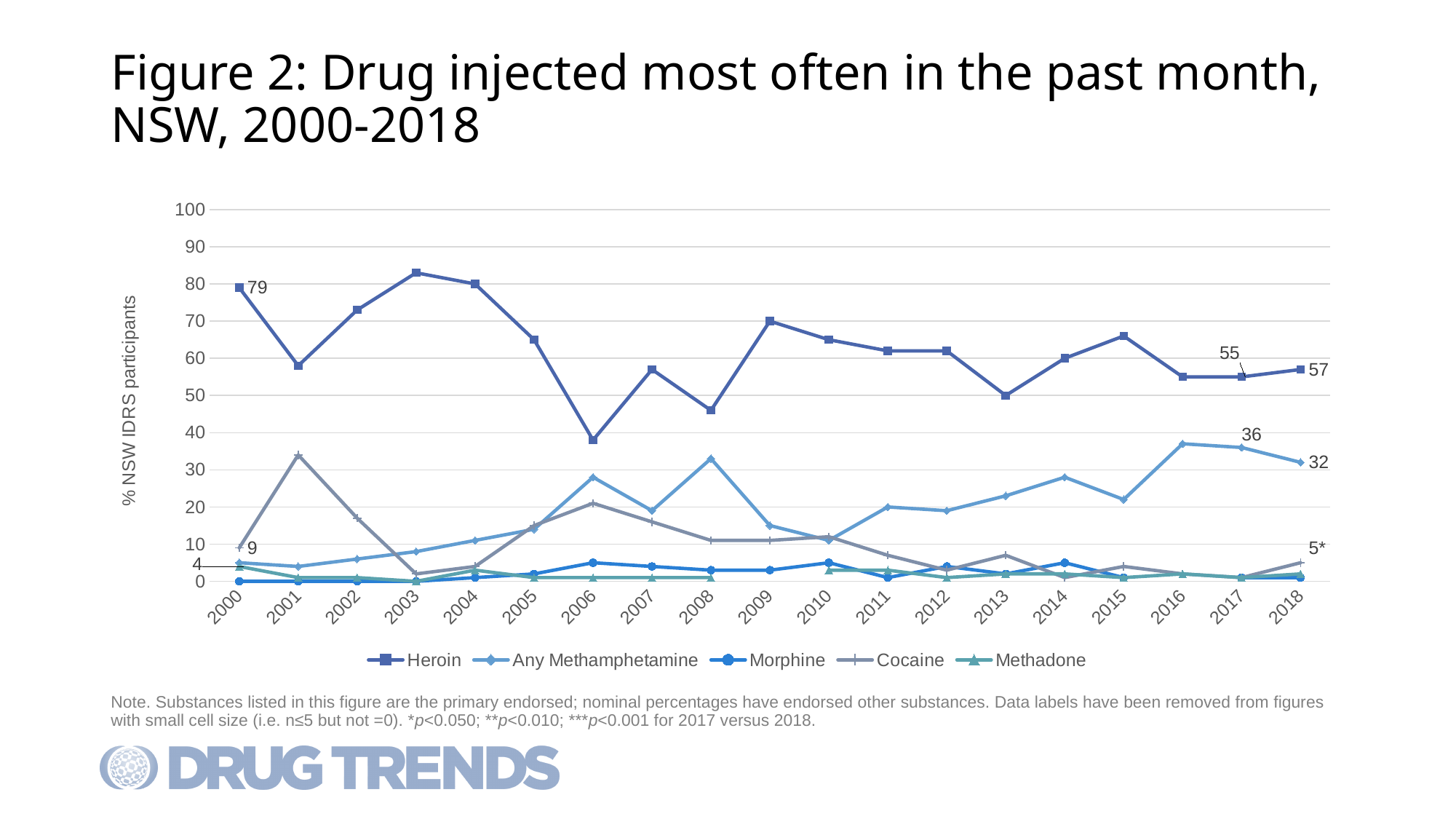
What was the percentage for Heroin in 2000? 79 By how much did the Heroin value change from 2017 to 2018? 2 How many years are shown on the x axis? 19 How many series does the legend list? 5 What was the percentage for Heroin in 2018? 57 What was the percentage for Cocaine in 2000? 9 What was the percentage for Any Methamphetamine in 2017? 36 In 2018, which is larger: the value for Heroin or for Any Methamphetamine? Heroin What kind of chart is shown on the slide? line chart Is the value for Heroin in 2008 greater or less than 50? less What is the difference between the Any Methamphetamine values in 2017 and 2018? 4 Did the Any Methamphetamine value rise or fall from 2016 to 2018? fall